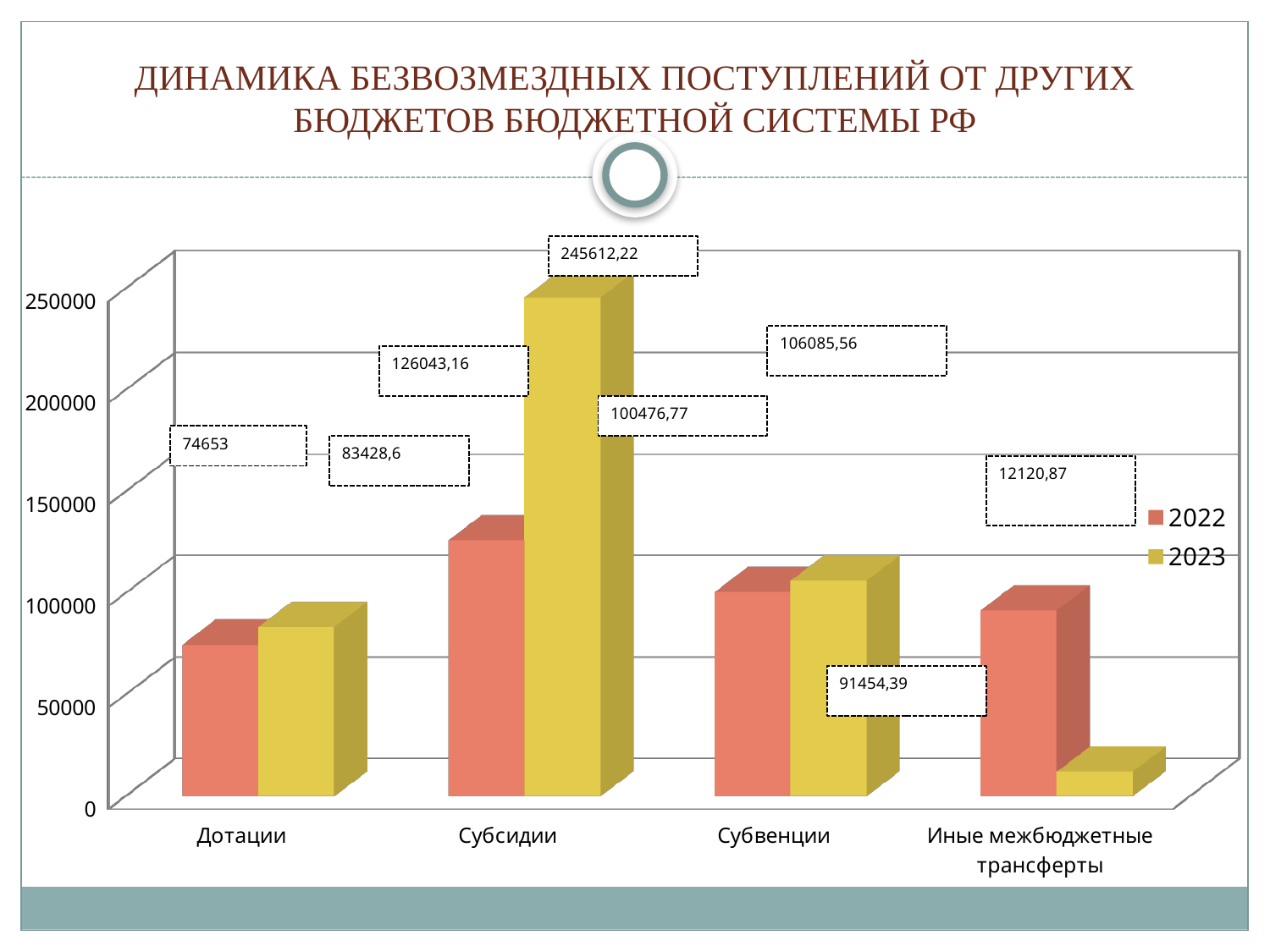
Which category has the highest value in the 2023 series? Субсидии For Дотации, which series has the larger value, 2022 or 2023? 2023 What is the difference between the 2022 and 2023 values for Иные межбюджетные трансферты? 79333,52 How many categories are shown on the x axis? 4 What kind of chart is shown on the slide? Bar chart What is the value for Дотации in the 2022 series? 74653 Which category has the lowest value in the 2023 series? Иные межбюджетные трансферты How many series does the legend list? 2 What is the value for Субсидии in the 2023 series? 245612,22 What is the difference between the 2023 and 2022 values for Субсидии? 119569,06 What is the value for Иные межбюджетные трансферты in the 2023 series? 12120,87 What is the value for Субвенции in the 2022 series? 100476,77